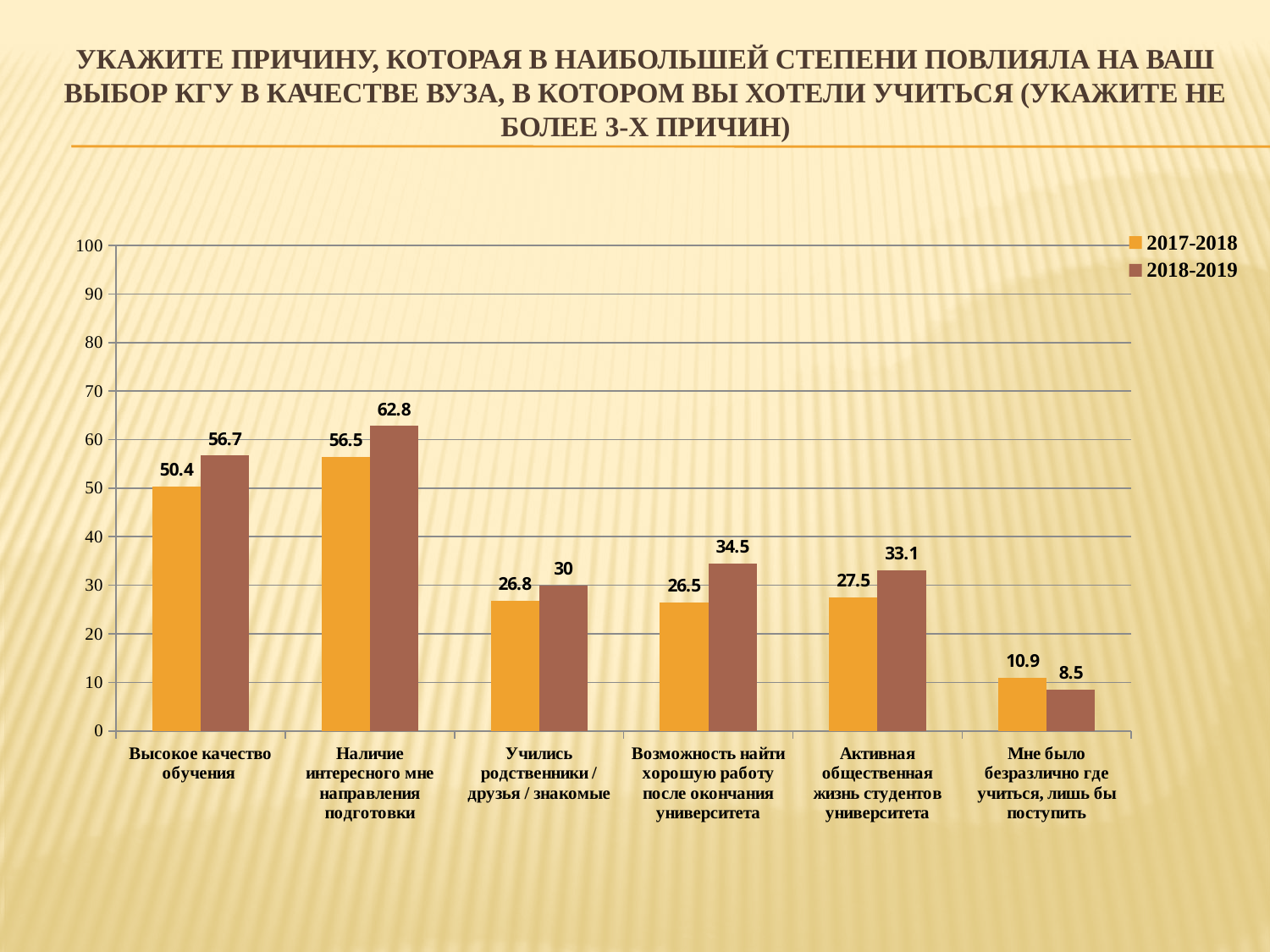
Which series is shown in orange in the legend? 2017-2018 What kind of chart is shown on the slide? Bar chart For «Мне было безразлично где учиться, лишь бы поступить», which series has the larger value, 2017-2018 or 2018-2019? 2017-2018 How many series does the legend list? 2 What is the difference between the 2018-2019 and 2017-2018 values for «Активная общественная жизнь студентов университета»? 5.6 What is the 2017-2018 value for «Высокое качество обучения»? 50.4 What is the 2018-2019 value for «Учились родственники / друзья / знакомые»? 30 Is the 2018-2019 value for «Возможность найти хорошую работу после окончания университета» greater or less than 30? greater What is the 2018-2019 value for «Наличие интересного мне направления подготовки»? 62.8 Which category has the lowest 2017-2018 value? Мне было безразлично где учиться, лишь бы поступить Which category has the highest 2018-2019 value? Наличие интересного мне направления подготовки How many categories are shown on the x axis? 6